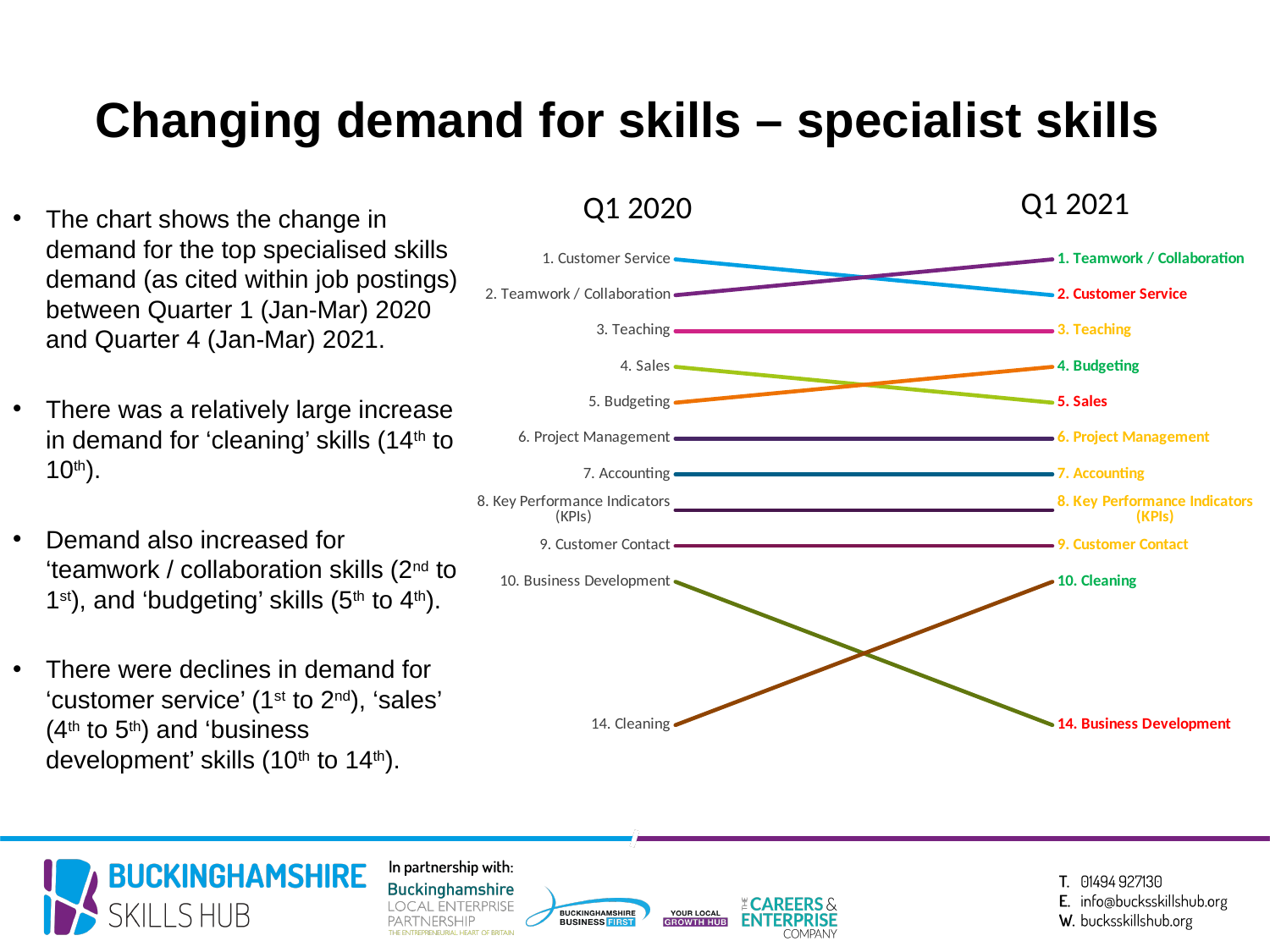
By how many places did Cleaning's rank change between Q1 2020 and Q1 2021? 4 Which skill was ranked 1st in Q1 2020? Customer Service Which skill was ranked 1st in Q1 2021? Teamwork / Collaboration What are the two time periods compared in the chart? Q1 2020 and Q1 2021 Did the rank of Sales rise or fall from Q1 2020 to Q1 2021? Fall (4th to 5th) What rank did Business Development hold in Q1 2021? 14 What kind of chart is shown on the slide? Line chart (slope chart) How many skills are plotted on the chart? 11 What rank did Budgeting hold in Q1 2020? 5 What rank did Cleaning hold in Q1 2021? 10 What rank did Cleaning hold in Q1 2020? 14 Which skill has the lowest rank (largest rank number) in Q1 2021? Business Development